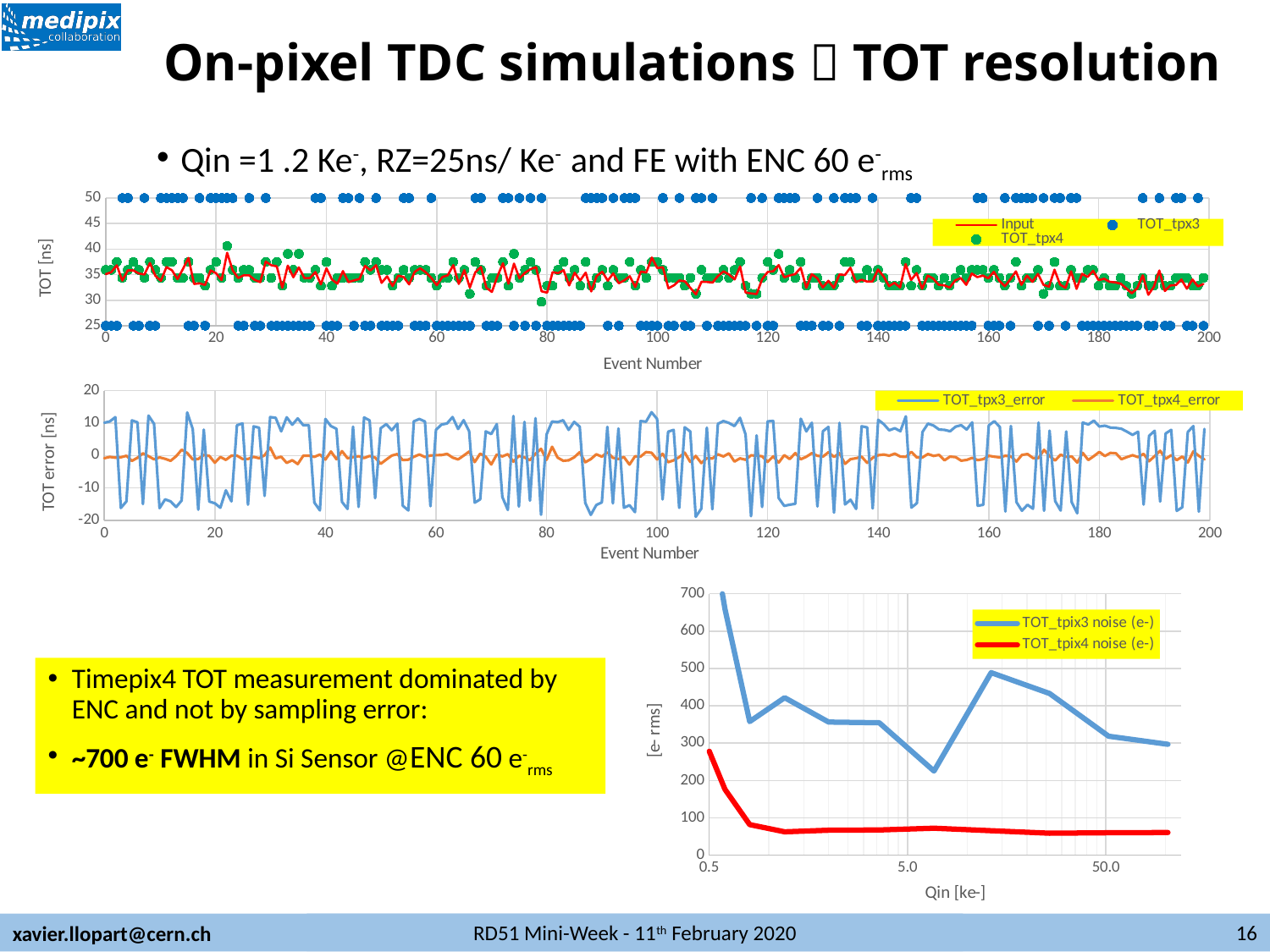
In the bottom-right chart (noise vs Qin), what kind of chart is it? line chart In the top chart (TOT vs Event Number), is the value of the Input series at event 100 greater or less than 45? less In the bottom-right chart (noise vs Qin), is the value of TOT_tpix4 noise (e-) at Qin = 50.0 greater or less than 100? less In the bottom-right chart (noise vs Qin), which series has the higher value at Qin = 5.0, TOT_tpix3 noise (e-) or TOT_tpix4 noise (e-)? TOT_tpix3 noise (e-) In the bottom-right chart (noise vs Qin), is the highest value of TOT_tpix3 noise (e-) greater or less than 600? greater In the bottom-right chart (noise vs Qin), does the TOT_tpix4 noise (e-) series overall rise or fall as Qin increases? fall In the bottom-right chart (noise vs Qin), what is the label of the x axis? Qin [ke-] In the middle chart (TOT error vs Event Number), which series stays closer to 0 across the events, TOT_tpx3_error or TOT_tpx4_error? TOT_tpx4_error In the middle chart (TOT error vs Event Number), how many series does the legend list? 2 In the bottom-right chart (noise vs Qin), which series is drawn in red? TOT_tpix4 noise (e-) In the top chart (TOT vs Event Number), how many series does the legend list? 3 In the bottom-right chart (noise vs Qin), how many series does the legend list? 2